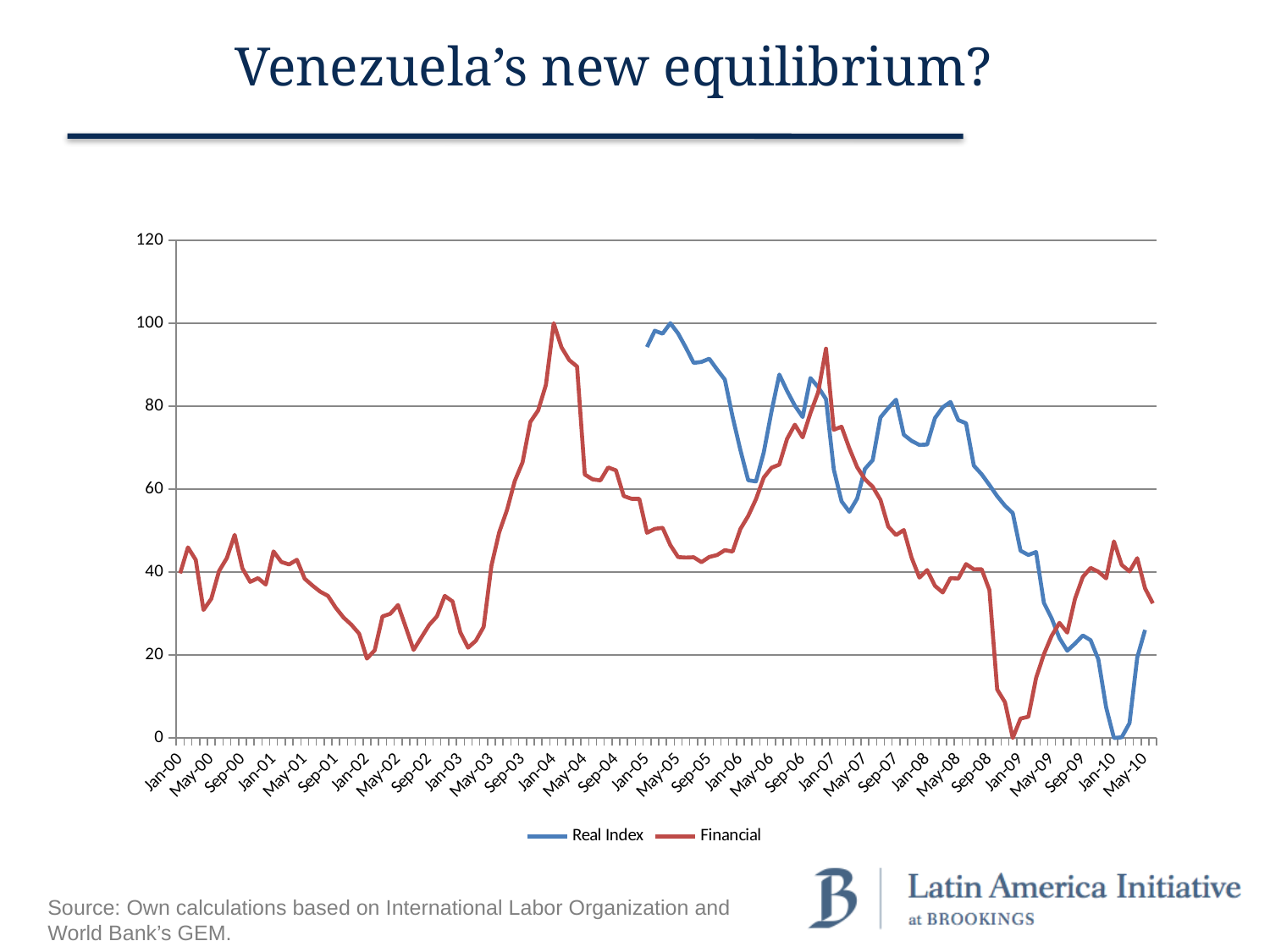
Is the value of the Real Index series at May-05 greater or less than 80? greater How many series does the legend list? 2 What kind of chart is shown on the slide? line chart Is the value of the Financial series at Jan-04 greater or less than 80? greater Is the value of the Financial series at Jan-09 greater or less than 20? less In which month does the Financial series reach its highest value? Jan-04 What is the title of the slide containing the chart? Venezuela's new equilibrium? At Jan-06, which series has the higher value, Real Index or Financial? Real Index What are the two series named in the legend? Real Index and Financial Does the Financial series rise or fall between Jan-03 and Jan-04? rise At Jan-09, which series has the higher value, Real Index or Financial? Real Index